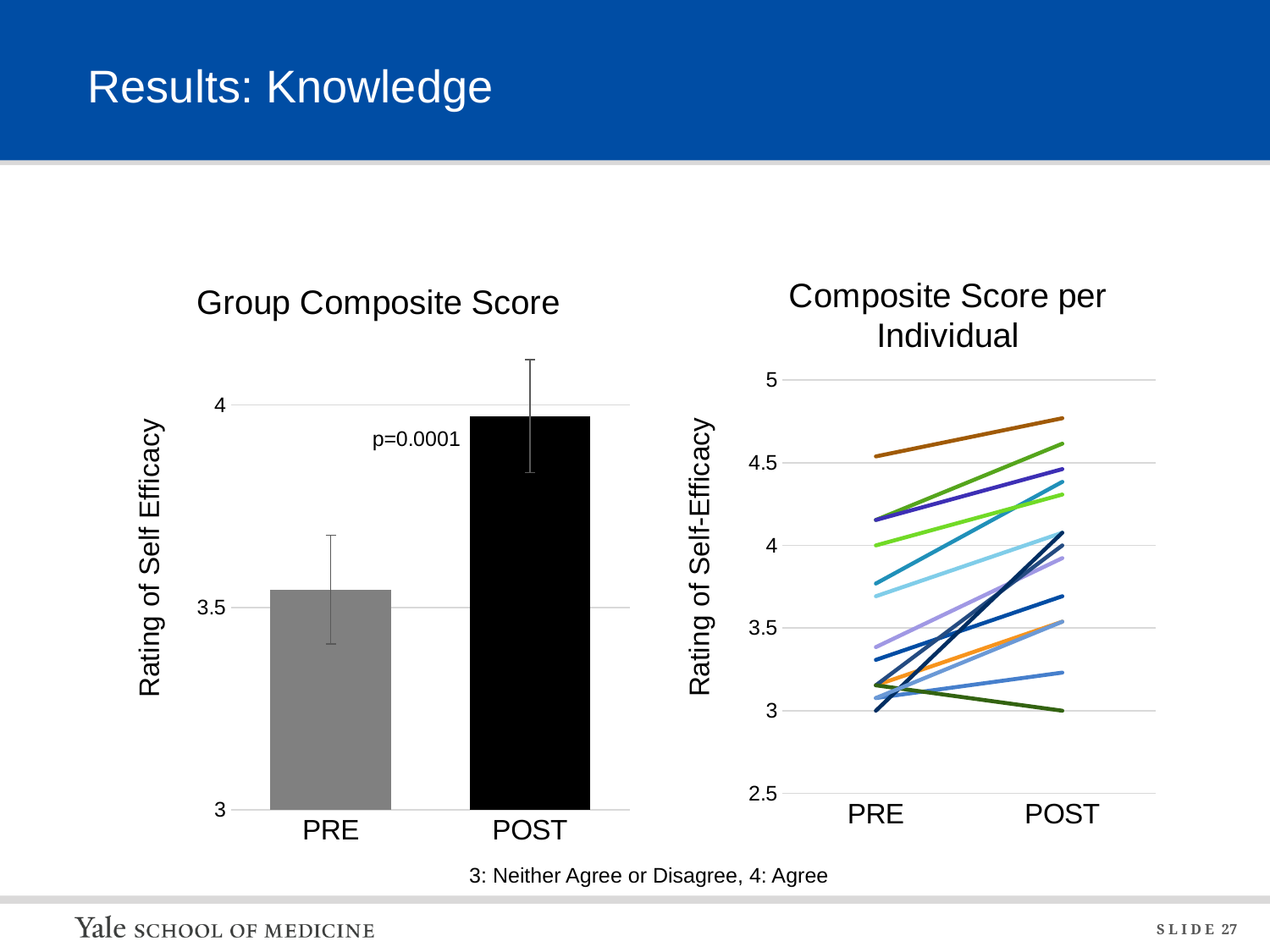
In the "Group Composite Score" chart, which category has the higher bar, PRE or POST? POST What is the y-axis title of the "Group Composite Score" chart? Rating of Self Efficacy What kind of chart is the "Group Composite Score" chart? bar chart How many categories are shown on the x axis of the "Composite Score per Individual" chart? 2 In the "Group Composite Score" chart, is the value for PRE greater or less than 4? less In the "Group Composite Score" chart, which category has the lowest value? PRE What p-value is annotated on the "Group Composite Score" chart? p=0.0001 In the "Composite Score per Individual" chart, do most of the lines rise or fall from PRE to POST? rise How many categories are shown on the x axis of the "Group Composite Score" chart? 2 What kind of chart is the "Composite Score per Individual" chart? line chart In the "Group Composite Score" chart, is the value for POST greater or less than 3.5? greater